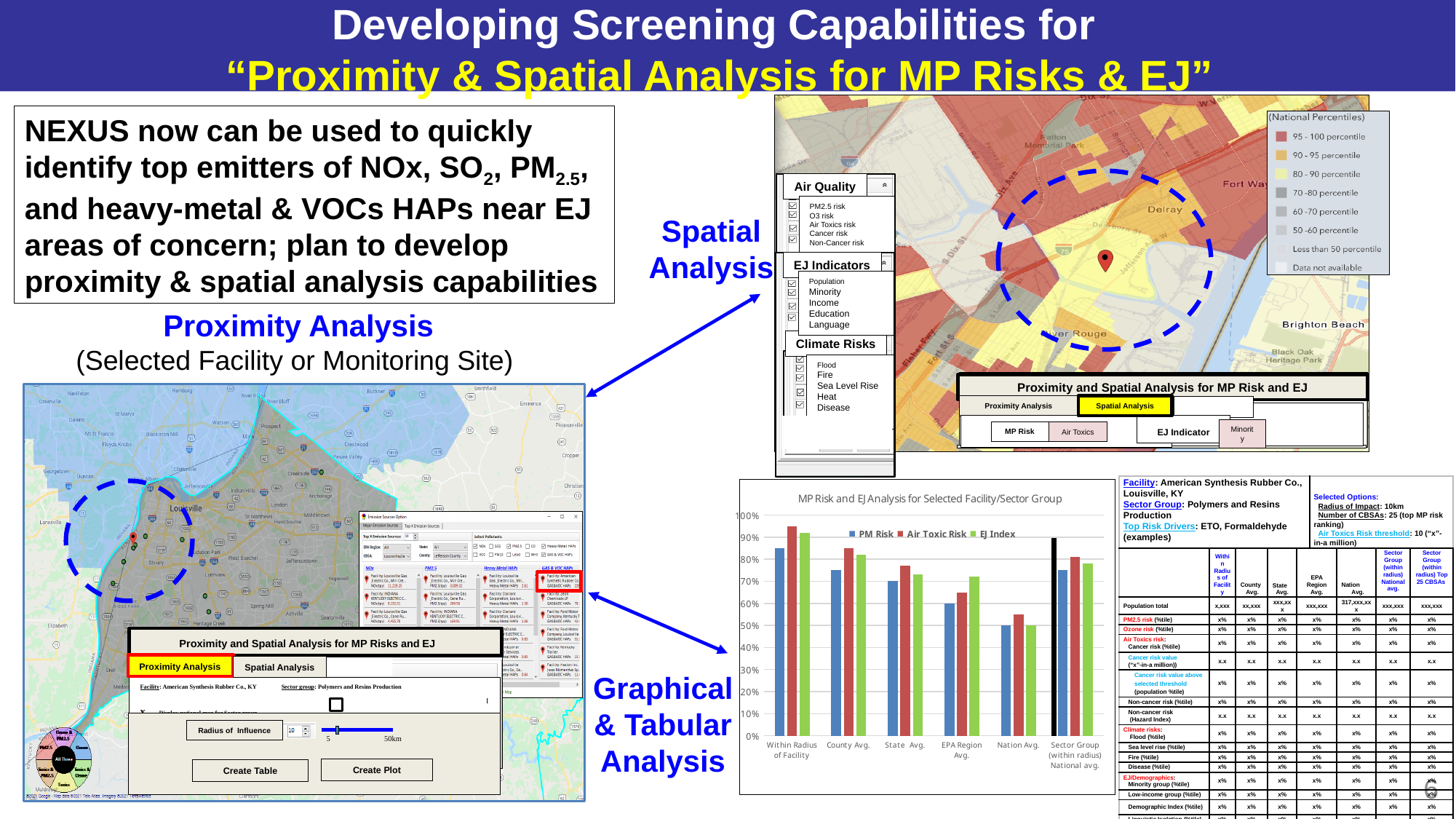
What kind of chart is shown on the slide? bar chart In the bar chart, is the PM Risk value for Nation Avg. greater or less than 60%? less What are the three series named in the legend of the bar chart? PM Risk, Air Toxic Risk, EJ Index In the bar chart, is the EJ Index value for EPA Region Avg. greater or less than 60%? greater In the bar chart, is the Air Toxic Risk value for Within Radius of Facility greater or less than 90%? greater In the bar chart, which category has the lowest PM Risk value? Nation Avg. In the bar chart, does the PM Risk value rise or fall from Within Radius of Facility to Nation Avg.? fall In the bar chart, which is larger: the Air Toxic Risk for Within Radius of Facility or the Air Toxic Risk for Nation Avg.? Within Radius of Facility How many categories are shown along the x axis of the bar chart? 6 What is the title of the bar chart? MP Risk and EJ Analysis for Selected Facility/Sector Group In the bar chart, which category has the highest Air Toxic Risk value? Within Radius of Facility How many series does the legend of the bar chart list? 3